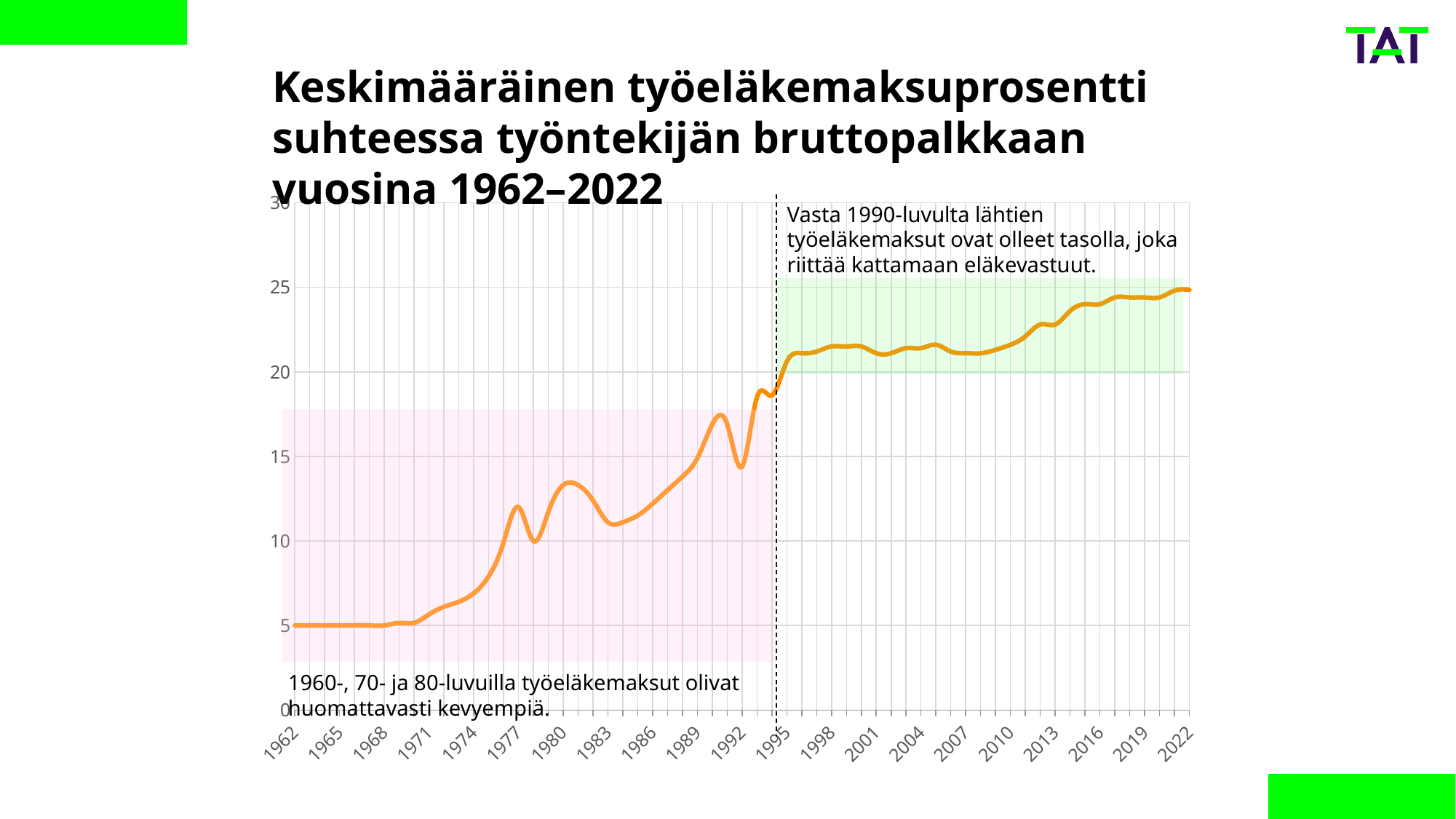
Is the value for 2022 greater or less than 20? greater Is the value for 2001 greater or less than 20? greater Is the value for 1983 greater or less than 10? greater Which year has the larger value, 1962 or 2022? 2022 How many year labels are shown on the x axis? 21 Which year has the larger value, 2001 or 2013? 2013 Overall, do the values rise or fall from 1962 to 2022? rise What kind of chart is shown on the slide? line chart What is the title of the chart? Keskimääräinen työeläkemaksuprosentti suhteessa työntekijän bruttopalkkaan vuosina 1962–2022